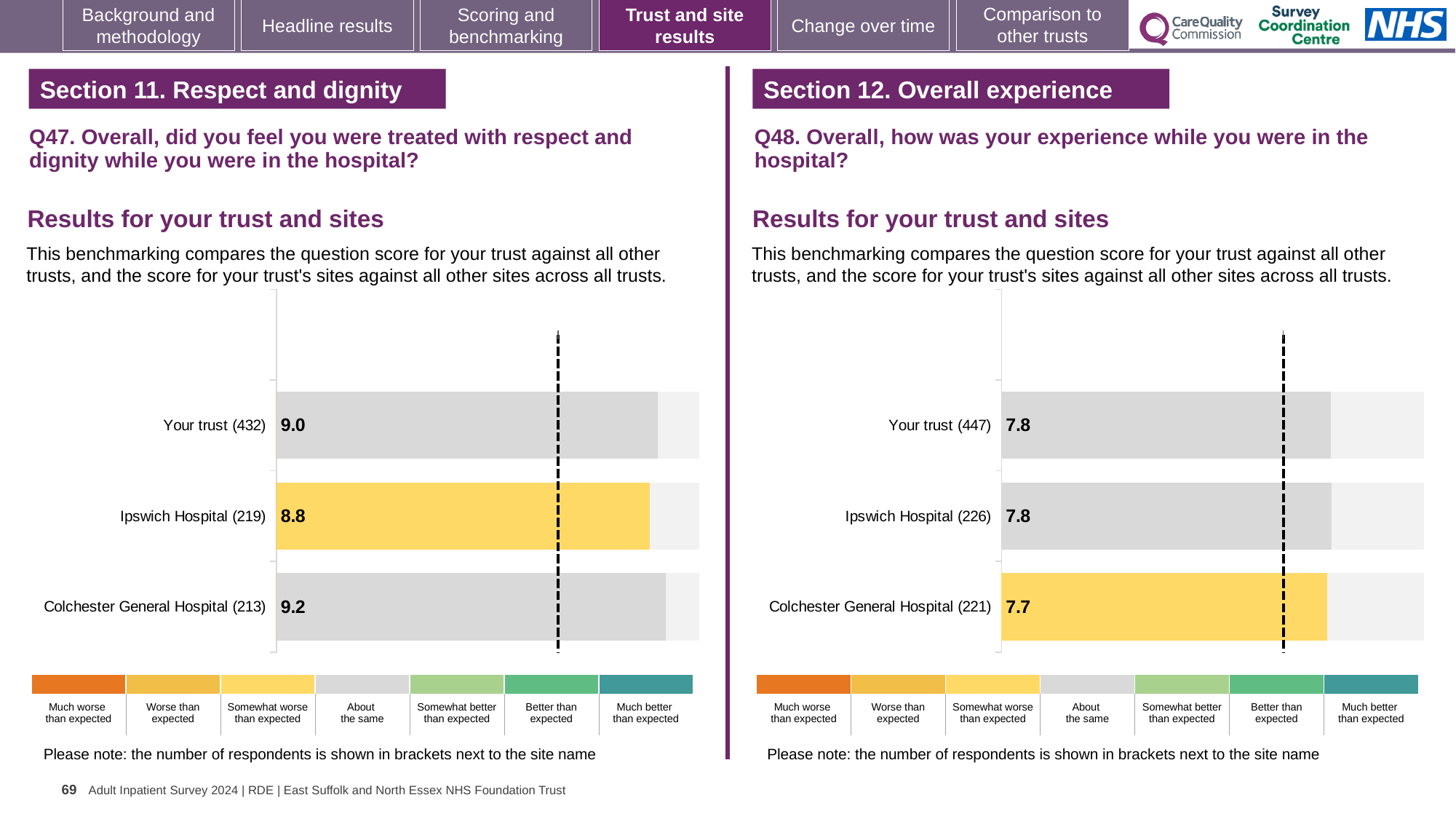
In the Q47 chart on the left, what is the difference between the scores for Colchester General Hospital (213) and Ipswich Hospital (219)? 0.4 In the Q48 chart on the right, which bar is coloured yellow (somewhat worse than expected)? Colchester General Hospital (221) What kind of chart is used in the Q48 chart on the right? Bar chart In the Q48 chart on the right, what is the difference between the scores for Ipswich Hospital (226) and Colchester General Hospital (221)? 0.1 In the Q47 chart on the left, what is the score for Ipswich Hospital (219)? 8.8 In the Q48 chart on the right, what is the score for Colchester General Hospital (221)? 7.7 In the Q47 chart on the left, what is the score for Your trust (432)? 9.0 In the Q47 chart on the left, which site or trust has the highest score? Colchester General Hospital (213) In the Q48 chart on the right, which site or trust has the lowest score? Colchester General Hospital (221) In the Q48 chart on the right, what is the score for Your trust (447)? 7.8 How many bars are plotted in the Q47 chart on the left? 3 In the Q47 chart on the left, which site or trust has the lowest score? Ipswich Hospital (219)